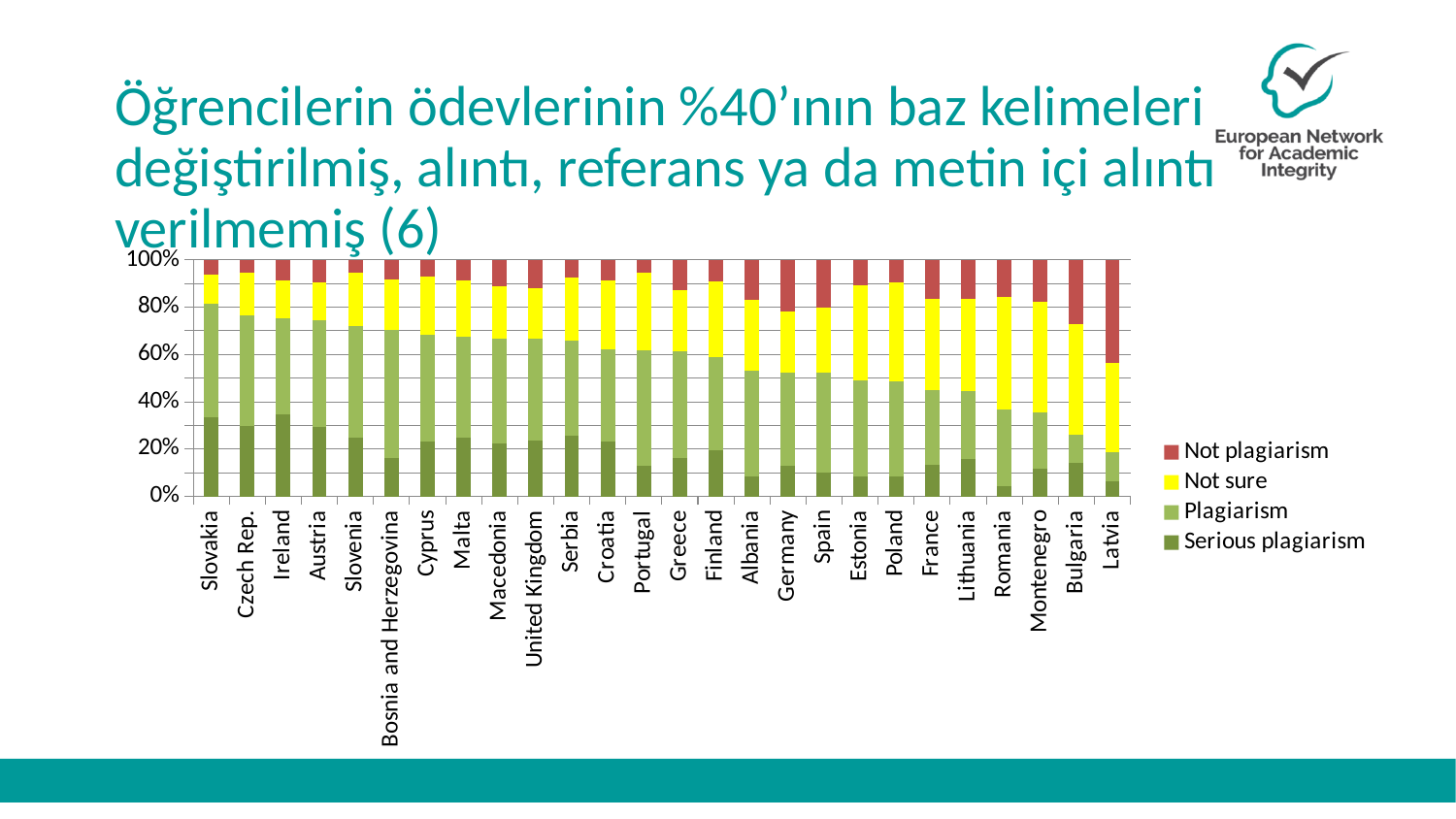
How many series does the legend list? 4 What kind of chart is shown on the slide? stacked bar chart How many countries are shown on the x axis of the chart? 26 Which colour represents 'Not plagiarism' in the legend? red Is the 'Serious plagiarism' value for Latvia greater or less than 20%? less Which country is listed first on the x axis? Slovakia Is the 'Serious plagiarism' value for Romania greater or less than 20%? less Which is larger, the 'Not plagiarism' value for Latvia or for Slovakia? Latvia Which is larger, the 'Serious plagiarism' value for Slovakia or for Latvia? Slovakia Moving from left to right along the x axis, does the combined share of 'Plagiarism' and 'Serious plagiarism' rise or fall? fall Is the 'Serious plagiarism' value for Slovakia greater or less than 20%? greater Which country has the largest 'Not plagiarism' segment? Latvia